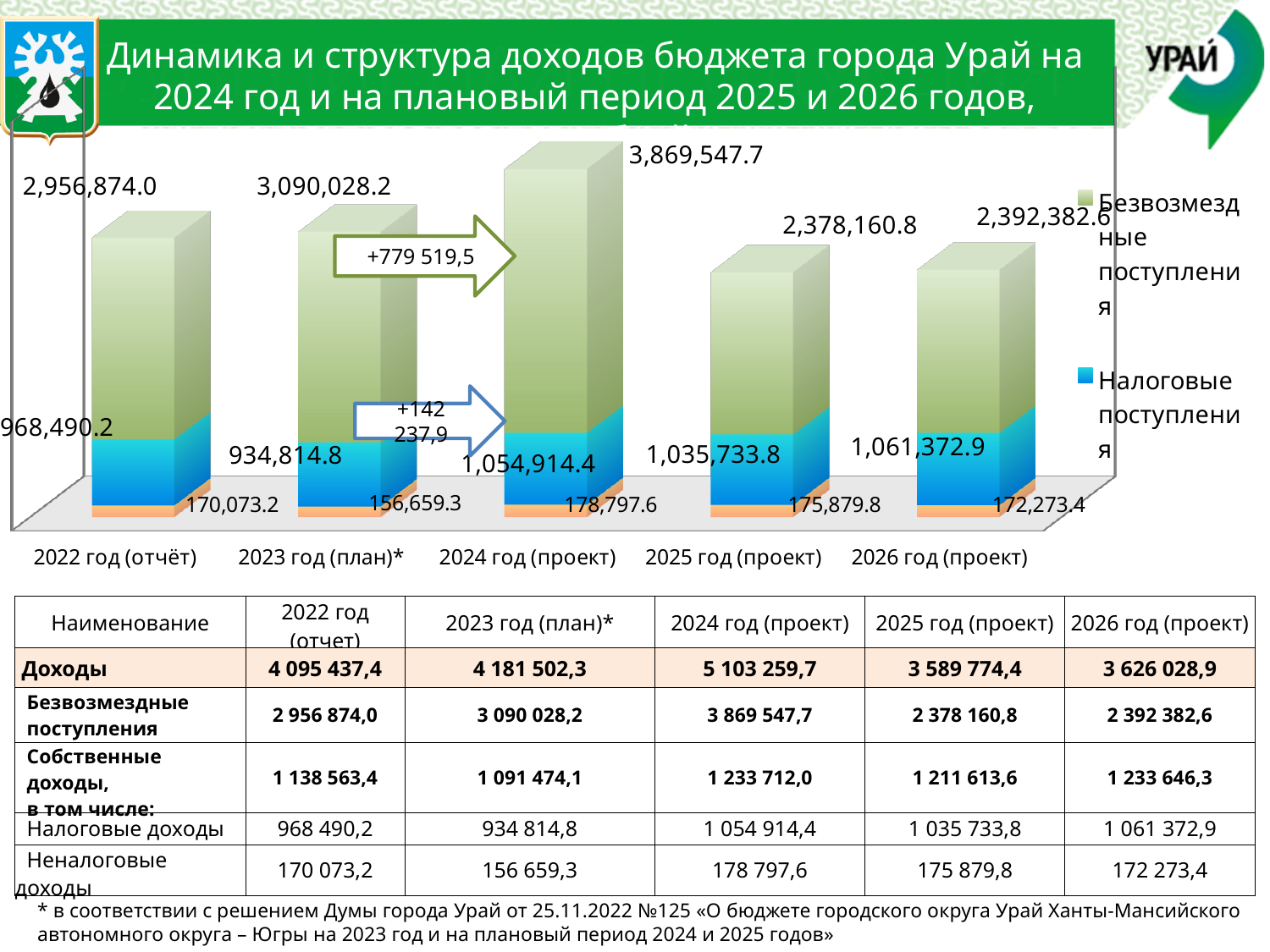
What is the value of Безвозмездные поступления for 2024 год (проект)? 3,869,547.7 How many year categories are shown on the chart? 5 In which year is Налоговые поступления highest? 2026 год (проект) How many series does the legend list? 2 In which year is Безвозмездные поступления lowest? 2025 год (проект) What kind of chart is shown on the slide? Stacked bar chart What is the value of the bottom (orange) segment for 2023 год (план)*? 156,659.3 What is the value of Налоговые поступления for 2022 год (отчёт)? 968,490.2 What is the total of the stacked bar for 2024 год (проект)? 5,103,259.7 Which is larger: Налоговые поступления in 2025 год (проект) or in 2026 год (проект)? 2026 год (проект) In which year is Безвозмездные поступления highest? 2024 год (проект) What is the difference in Безвозмездные поступления between 2024 год (проект) and 2023 год (план)*? 779,519.5